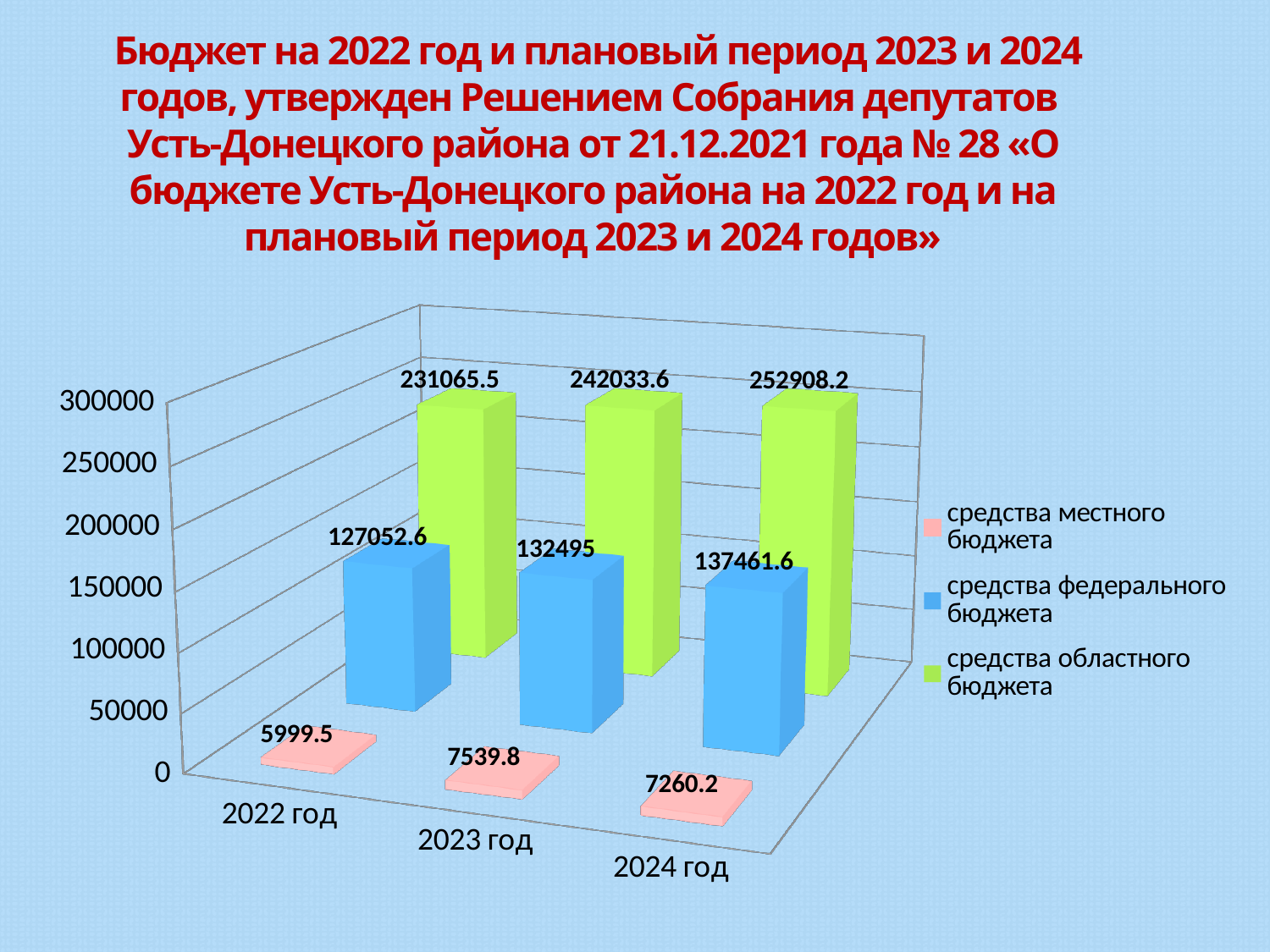
Which is larger: средства местного бюджета in 2023 год or in 2024 год? 2023 год In which year is the value for средства местного бюджета highest? 2023 год What is the value for средства областного бюджета in 2022 год? 231065.5 Is the value for средства федерального бюджета in 2022 год greater or less than 100000? greater How many series does the legend list? 3 What is the value for средства местного бюджета in 2024 год? 7260.2 In which year is the value for средства областного бюджета lowest? 2022 год What kind of chart is shown on the slide? bar chart What is the difference between the средства федерального бюджета values for 2024 год and 2022 год? 10409 How many years are shown on the x axis? 3 What is the difference between the средства областного бюджета values for 2024 год and 2022 год? 21842.7 What is the value for средства федерального бюджета in 2023 год? 132495